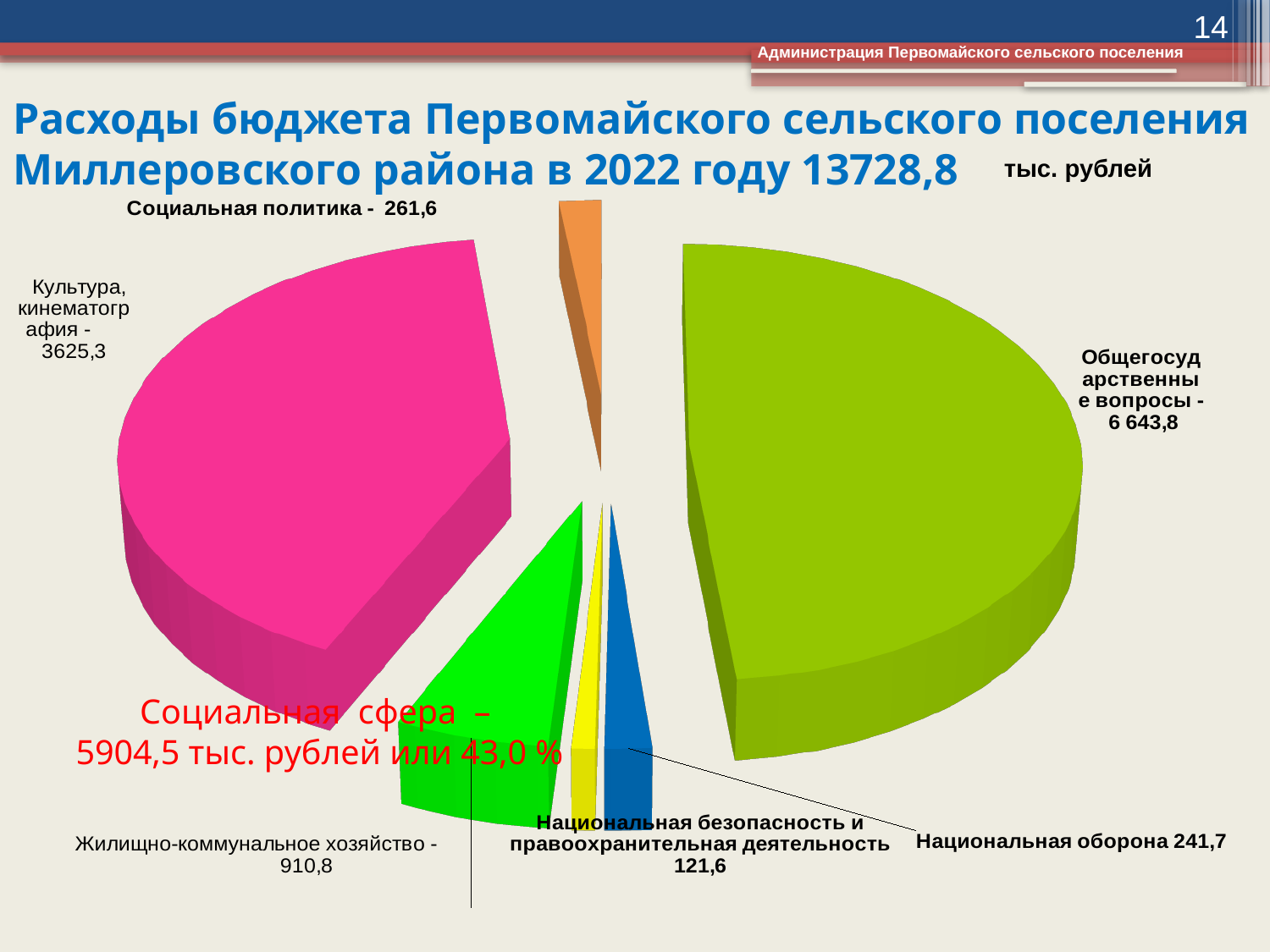
What total amount in тыс. рублей is stated in the chart title for 2022? 13728,8 What is the value for Культура, кинематография? 3625,3 What is the value for Жилищно-коммунальное хозяйство? 910,8 What is the value for Общегосударственные вопросы? 6 643,8 How many slices does the pie chart have? 6 Which category has the largest slice of the pie? Общегосударственные вопросы Which category has the smallest slice of the pie? Национальная безопасность и правоохранительная деятельность What is the difference between Общегосударственные вопросы and Культура, кинематография? 3018,5 Which is larger: Национальная оборона or Национальная безопасность и правоохранительная деятельность? Национальная оборона What is the value for Социальная политика? 261,6 What is the value for Национальная оборона? 241,7 What kind of chart is shown on the slide? Pie chart